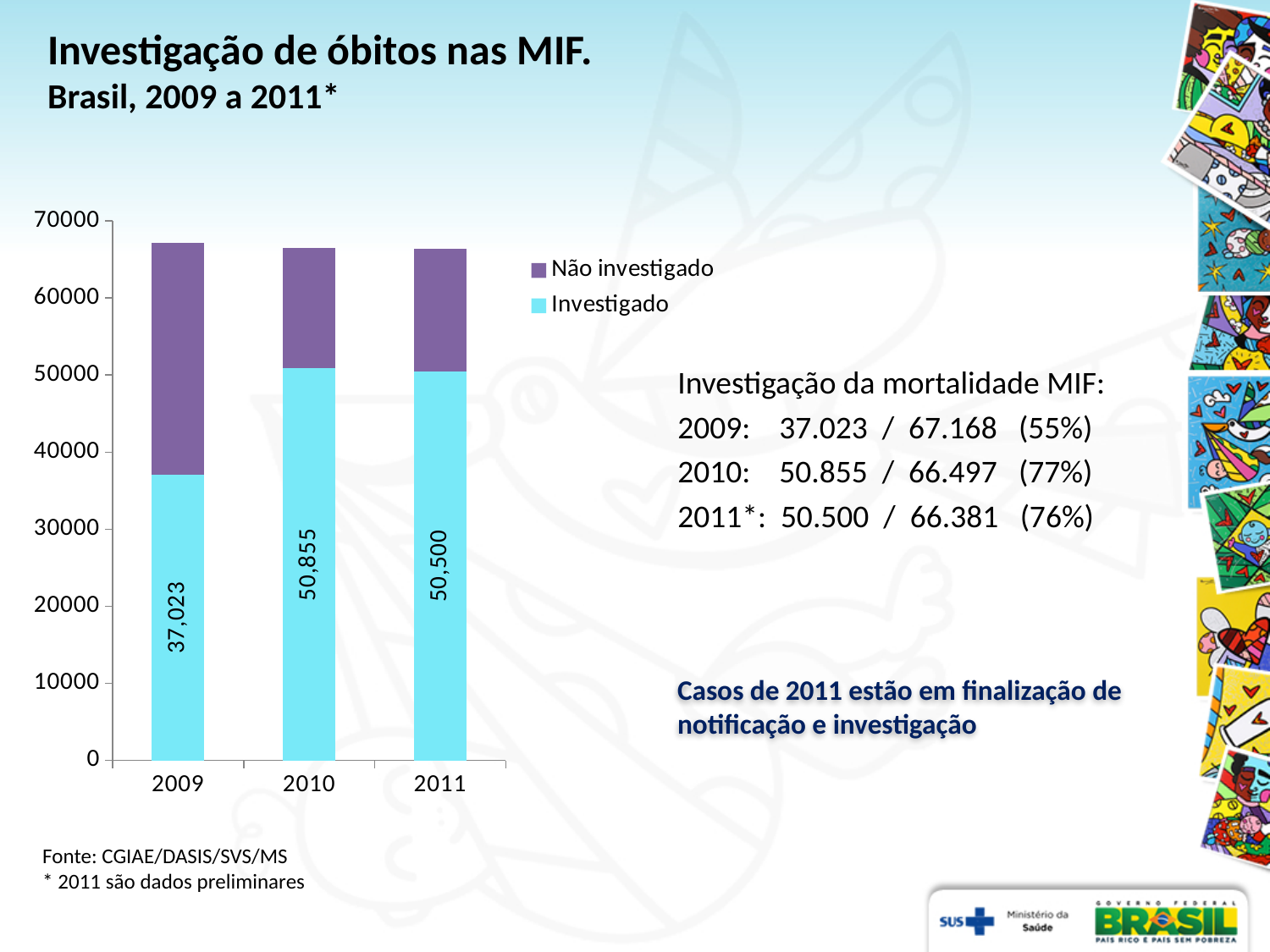
What kind of chart is shown on the slide? stacked bar chart Which is larger, the Investigado value for 2009 or for 2011? 2011 Is the total height of the 2009 stacked bar greater or less than 60000? greater What is the Investigado value for 2009? 37,023 What is the difference between the Investigado values for 2010 and 2009? 13,832 What is the difference between the Investigado values for 2010 and 2011? 355 What is the Investigado value for 2010? 50,855 How many years are shown on the x axis? 3 How many series does the legend list? 2 Which year has the lowest Investigado value? 2009 Which year has the highest Investigado value? 2010 What is the Investigado value for 2011? 50,500